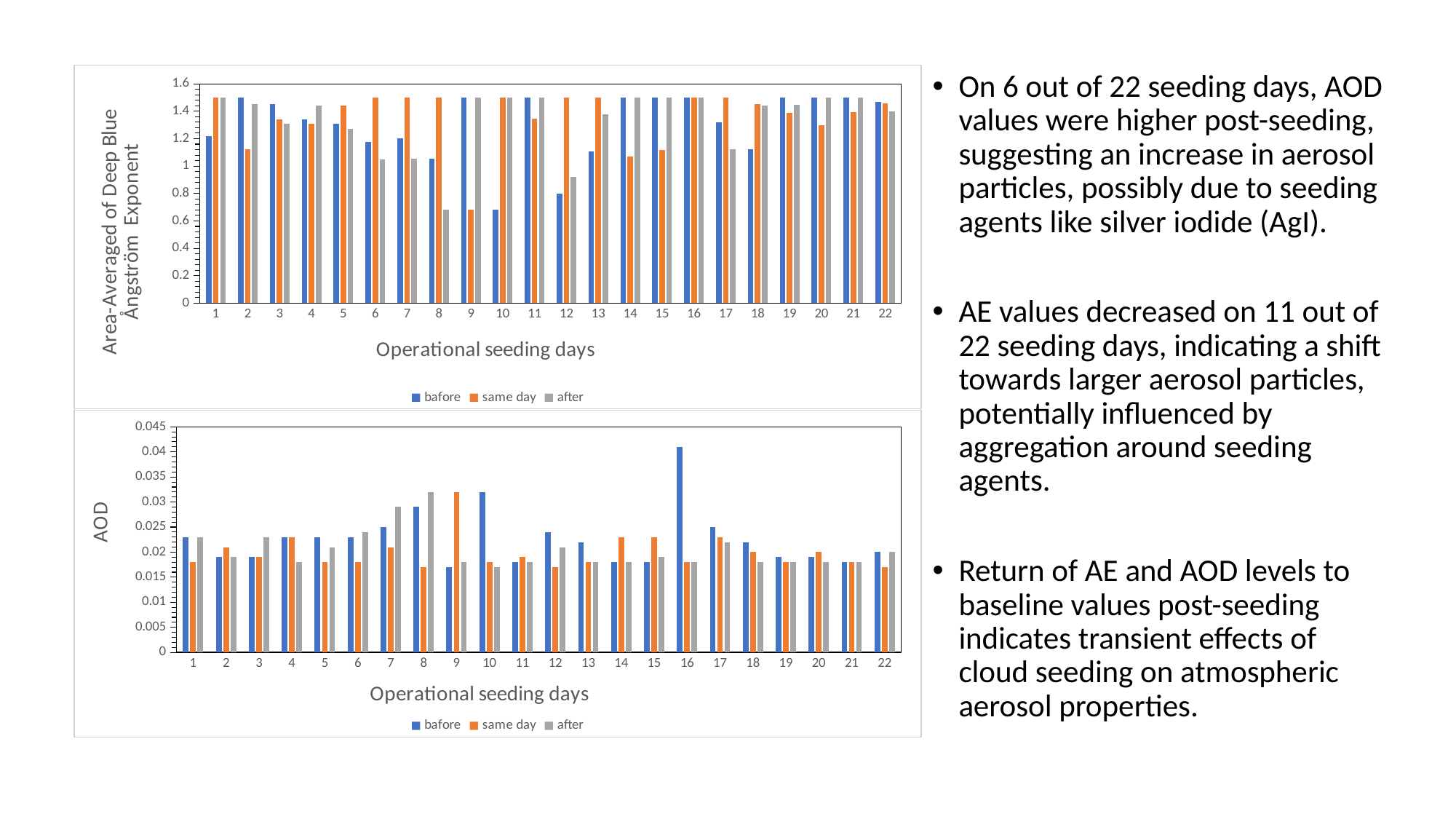
How many operational seeding days are shown on the x axis of the bottom chart (AOD)? 22 What is the x-axis title of the top chart? Operational seeding days In the bottom chart (AOD), is the 'after' value for day 8 greater or less than 0.03? greater What kind of chart is the top chart (Area-Averaged of Deep Blue Ångström Exponent)? bar chart How many series does the legend of the top chart list? 3 In the bottom chart (AOD), which is larger for day 16: the 'bafore' value or the 'same day' value? bafore What are the legend entries of the bottom chart (AOD)? bafore, same day, after In the top chart (Ångström Exponent), is the 'same day' value for day 9 greater or less than 1? less In the bottom chart (AOD), is the 'bafore' value for day 16 greater or less than 0.035? greater In the bottom chart (AOD), on which seeding day is the 'bafore' value highest? 16 In the top chart (Ångström Exponent), which is larger for day 12: the 'bafore' value or the 'same day' value? same day